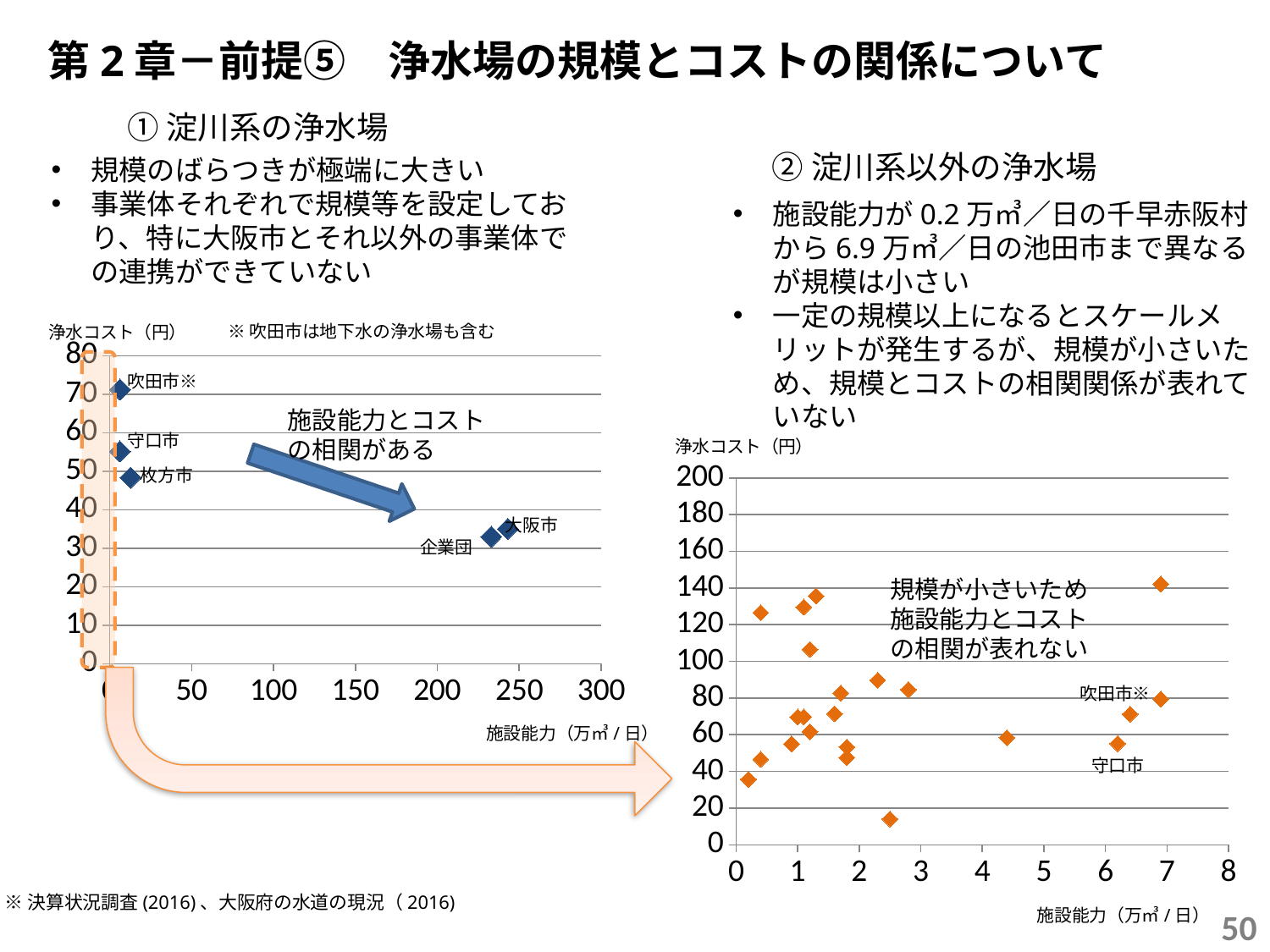
What is the x-axis title of the right chart (淀川系以外の浄水場)? 施設能力（万㎥/日） In the left chart (淀川系の浄水場), how many labeled data points are plotted? 5 In the left chart (淀川系の浄水場), which has the higher 浄水コスト, 吹田市※ or 守口市? 吹田市※ In the left chart (淀川系の浄水場), which labeled point has the highest 浄水コスト? 吹田市※ In the right chart (淀川系以外の浄水場), which has the higher 浄水コスト, 吹田市※ or 守口市? 吹田市※ In the right chart (淀川系以外の浄水場), is the 浄水コスト for 守口市 greater or less than 40? greater What kind of chart is the left chart (淀川系の浄水場)? scatter chart In the left chart (淀川系の浄水場), is the 浄水コスト for 吹田市※ greater or less than 60? greater In the left chart (淀川系の浄水場), is the 浄水コスト for 守口市 greater or less than 50? greater What kind of chart is the right chart (淀川系以外の浄水場)? scatter chart